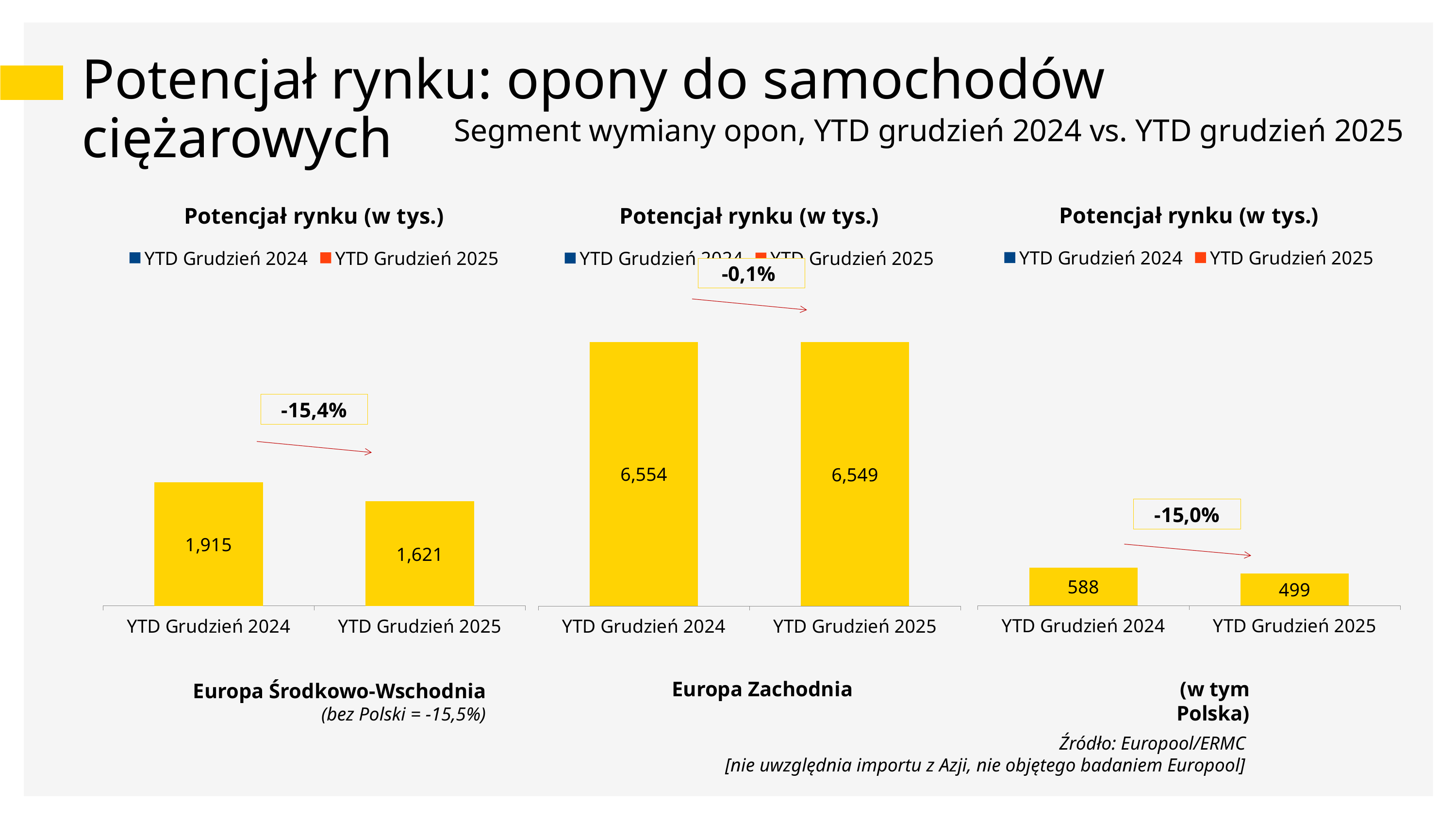
In the middle chart (Europa Zachodnia), what is the value for YTD Grudzień 2024? 6,554 How many series does the legend of the left chart (Europa Środkowo-Wschodnia) list? 2 In the right chart (w tym Polska), what is the difference between the YTD Grudzień 2024 and YTD Grudzień 2025 values? 89 In the left chart (Europa Środkowo-Wschodnia), what is the difference between the YTD Grudzień 2024 and YTD Grudzień 2025 values? 294 What kind of chart is the middle chart (Europa Zachodnia)? Bar chart In the left chart (Europa Środkowo-Wschodnia), what is the value for YTD Grudzień 2024? 1,915 In the left chart (Europa Środkowo-Wschodnia), what is the value for YTD Grudzień 2025? 1,621 In the left chart (Europa Środkowo-Wschodnia), which is larger: YTD Grudzień 2024 or YTD Grudzień 2025? YTD Grudzień 2024 In the middle chart (Europa Zachodnia), what is the value for YTD Grudzień 2025? 6,549 In the right chart (w tym Polska), what is the value for YTD Grudzień 2024? 588 In the right chart (w tym Polska), which bar is the lowest? YTD Grudzień 2025 In the right chart (w tym Polska), what is the value for YTD Grudzień 2025? 499